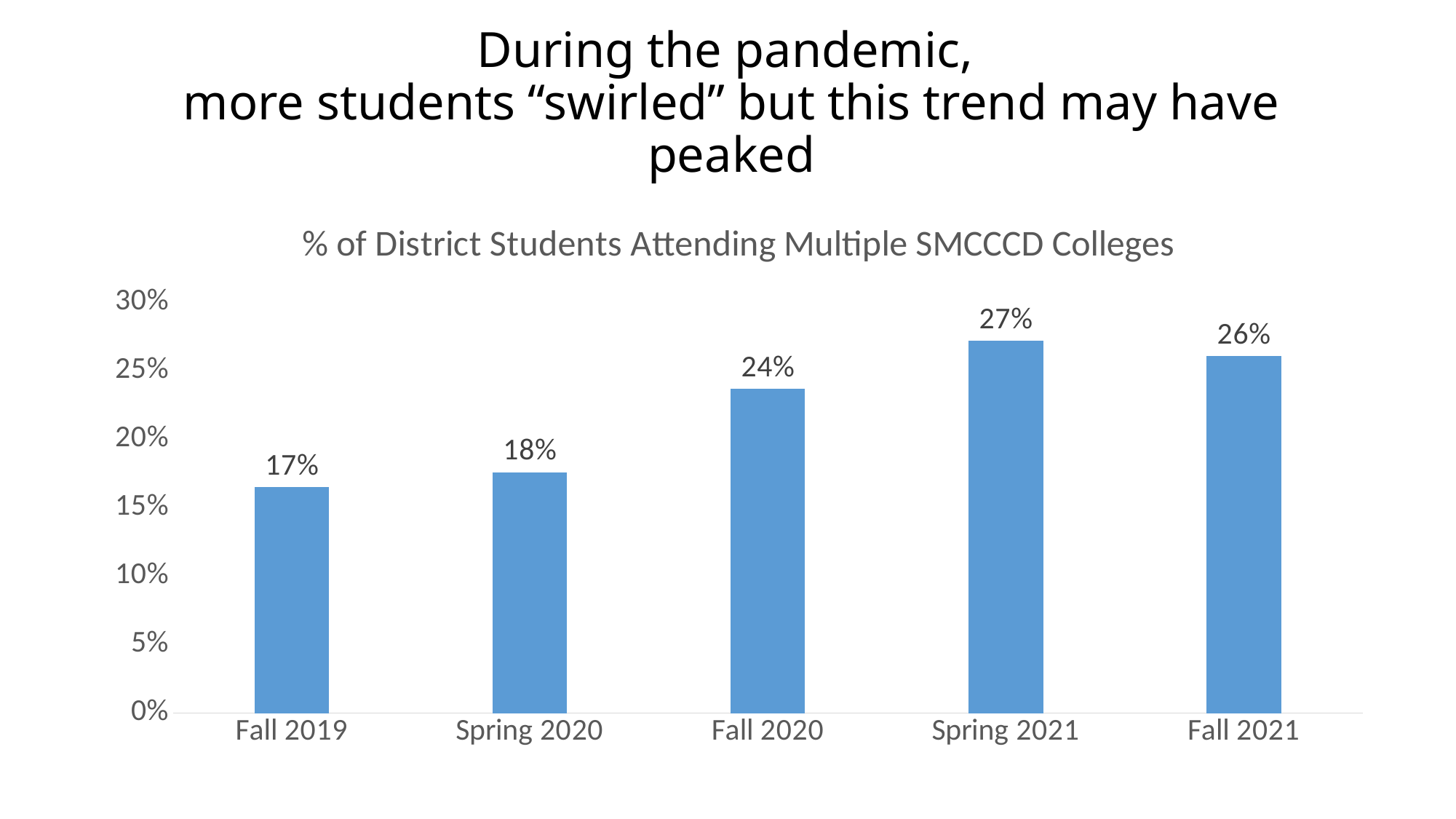
Which is larger, the value for Fall 2020 or the value for Fall 2021? Fall 2021 Do the values rise or fall from Fall 2019 to Spring 2021? Rise How many terms are shown on the x axis of the chart? 5 Which term has the highest percentage of students attending multiple SMCCCD colleges? Spring 2021 What is the value shown for Fall 2021? 26% What percentage of district students attended multiple SMCCCD colleges in Fall 2019? 17% Which term has the lowest percentage of students attending multiple SMCCCD colleges? Fall 2019 What is the value shown for Spring 2021? 27% What type of chart is shown on the slide? Bar chart What is the difference between the Spring 2021 value and the Fall 2019 value? 10% What is the title of the chart? % of District Students Attending Multiple SMCCCD Colleges What is the difference between the Fall 2020 value and the Spring 2020 value? 6%